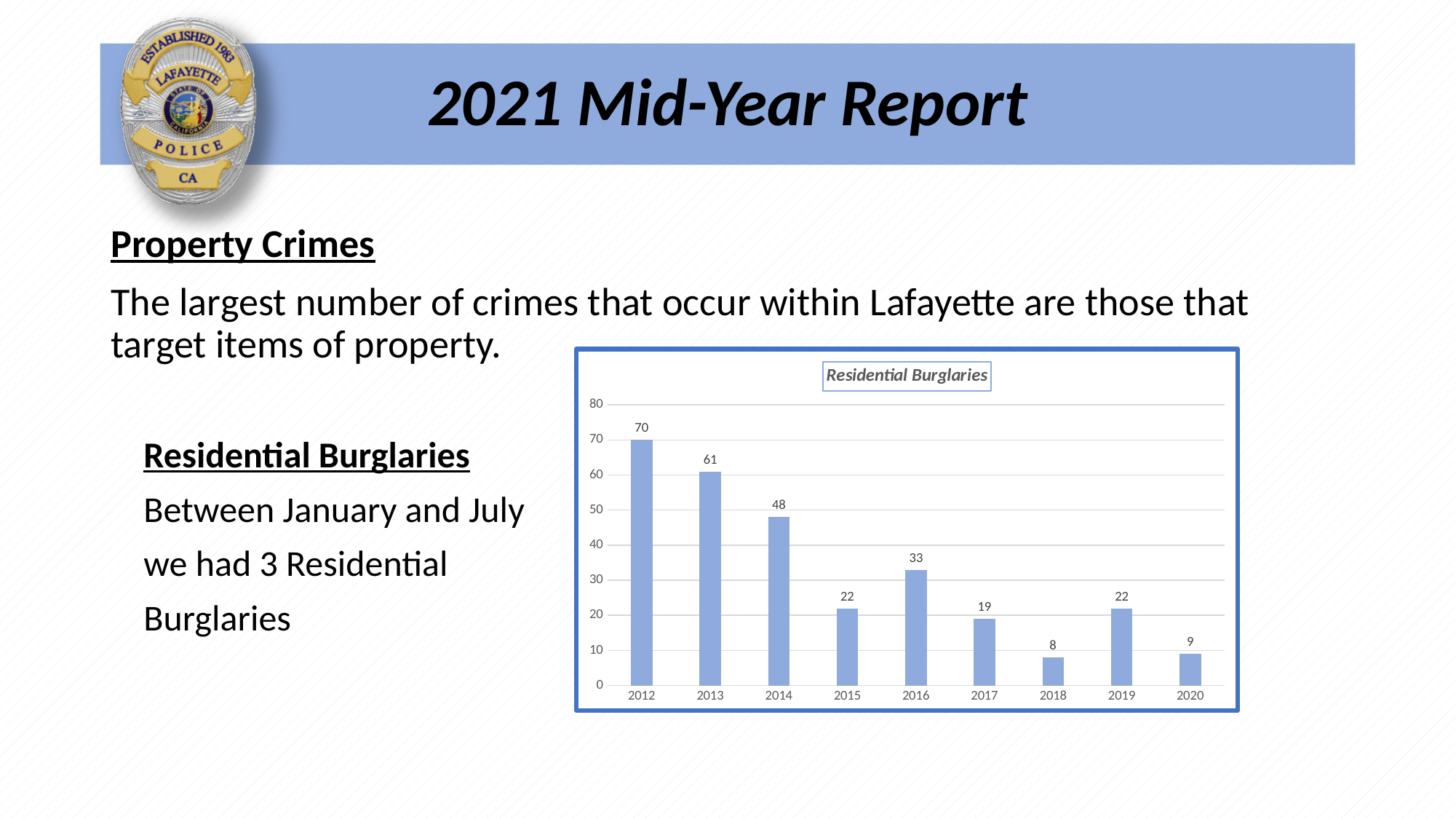
Which is larger, the value for 2017 or the value for 2020? 2017 Is the value for 2014 greater or less than 40? greater What kind of chart is shown on the slide? bar chart What is the value for 2018 in the Residential Burglaries chart? 8 What is the value for 2012 in the Residential Burglaries chart? 70 How many years are shown on the x axis of the chart? 9 What is the difference between the values for 2013 and 2014? 13 What is the value for 2016 in the Residential Burglaries chart? 33 Which year has the lowest number of residential burglaries? 2018 Which year has the highest number of residential burglaries? 2012 What is the title of the chart? Residential Burglaries Do the values generally rise or fall from 2012 to 2018? fall